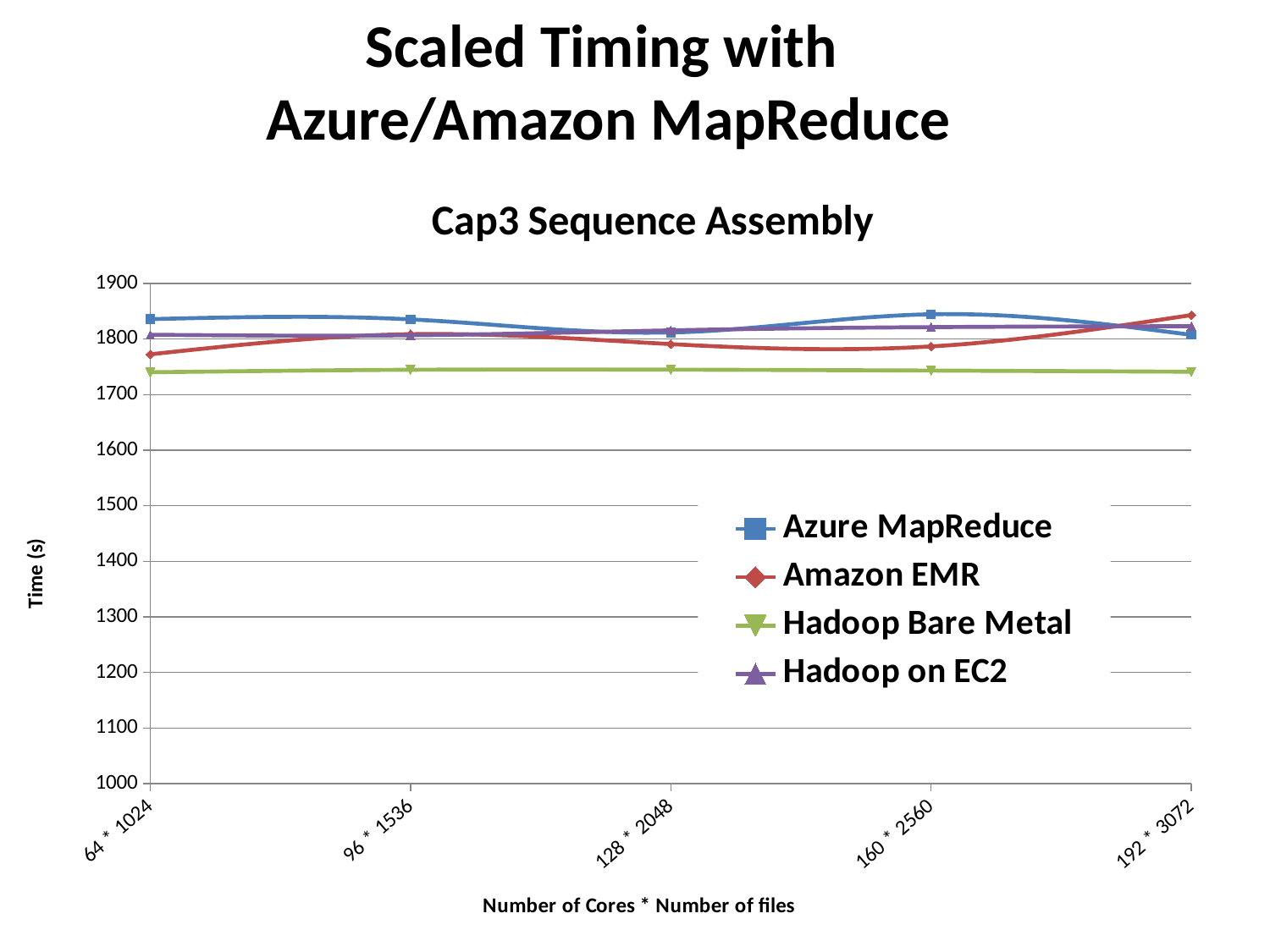
How many categories are shown along the x axis? 5 What kind of chart is shown on the slide? line chart Is the value for Hadoop Bare Metal at 128 * 2048 greater or less than 1800? less At 192 * 3072, which is higher: Amazon EMR or Azure MapReduce? Amazon EMR What is the label of the y axis? Time (s) What is the title of the chart? Cap3 Sequence Assembly How many series does the legend list? 4 Which series has the lowest time at 64 * 1024? Hadoop Bare Metal Is the value for Amazon EMR at 160 * 2560 greater or less than 1800? less At 64 * 1024, which is higher: Azure MapReduce or Amazon EMR? Azure MapReduce Is the value for Azure MapReduce at 64 * 1024 greater or less than 1800? greater